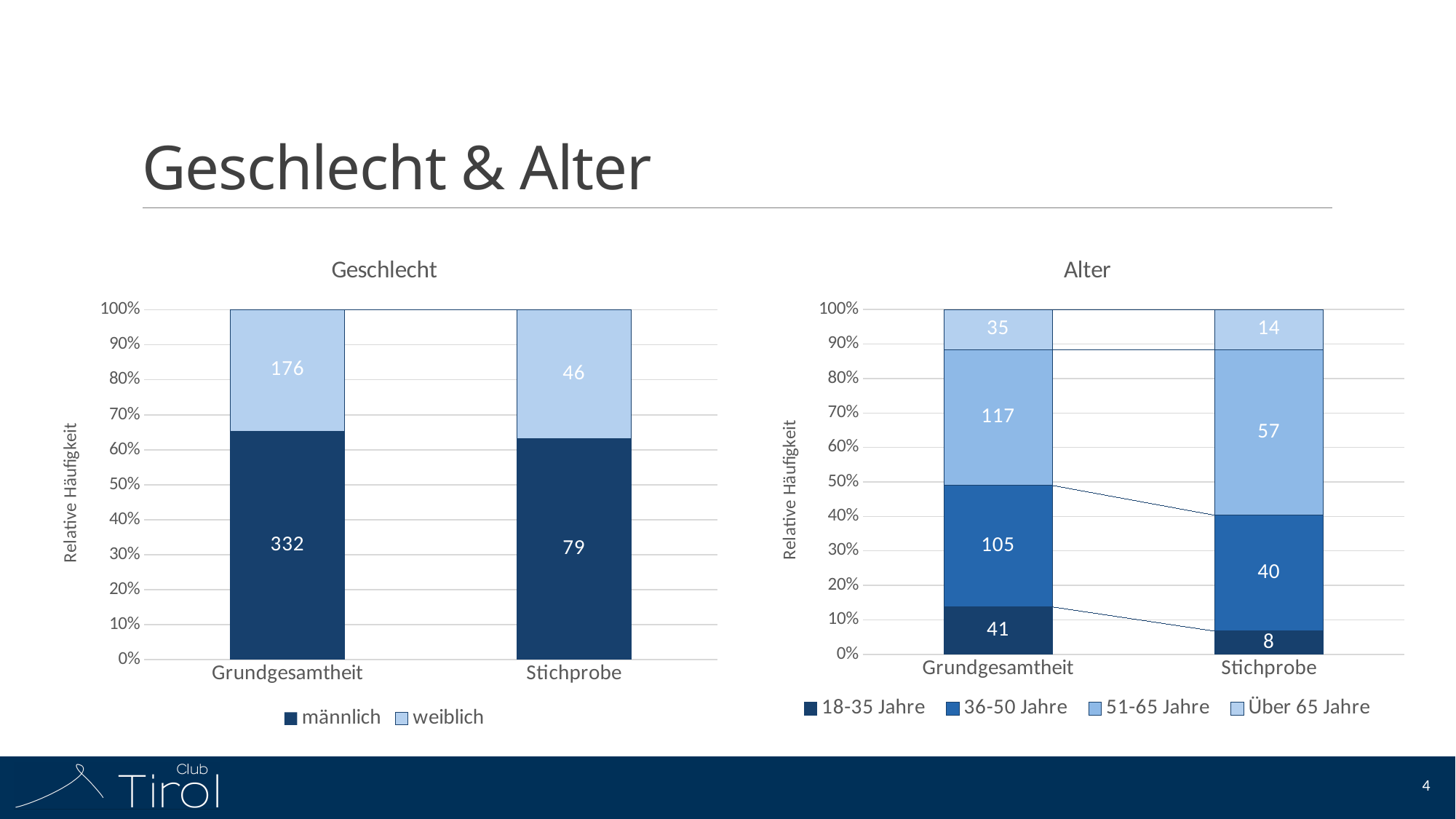
In the "Alter" chart, which age group has the lowest value in Stichprobe? 18-35 Jahre In the "Geschlecht" chart, what is the value for männlich in Grundgesamtheit? 332 In the "Alter" chart, which age group has the highest value in Grundgesamtheit? 51-65 Jahre In the "Alter" chart, what is the value for 51-65 Jahre in Grundgesamtheit? 117 In the "Geschlecht" chart, what is the value for weiblich in Stichprobe? 46 What kind of chart is the "Alter" chart? Stacked bar chart In the "Geschlecht" chart, how many series does the legend list? 2 In the "Geschlecht" chart, what is the total of the Grundgesamtheit bar? 508 In the "Alter" chart, how many series does the legend list? 4 In the "Alter" chart, what is the value for 18-35 Jahre in Stichprobe? 8 In the "Alter" chart, what is the total of the Stichprobe bar? 119 In the "Geschlecht" chart, what is the difference between männlich and weiblich in Stichprobe? 33